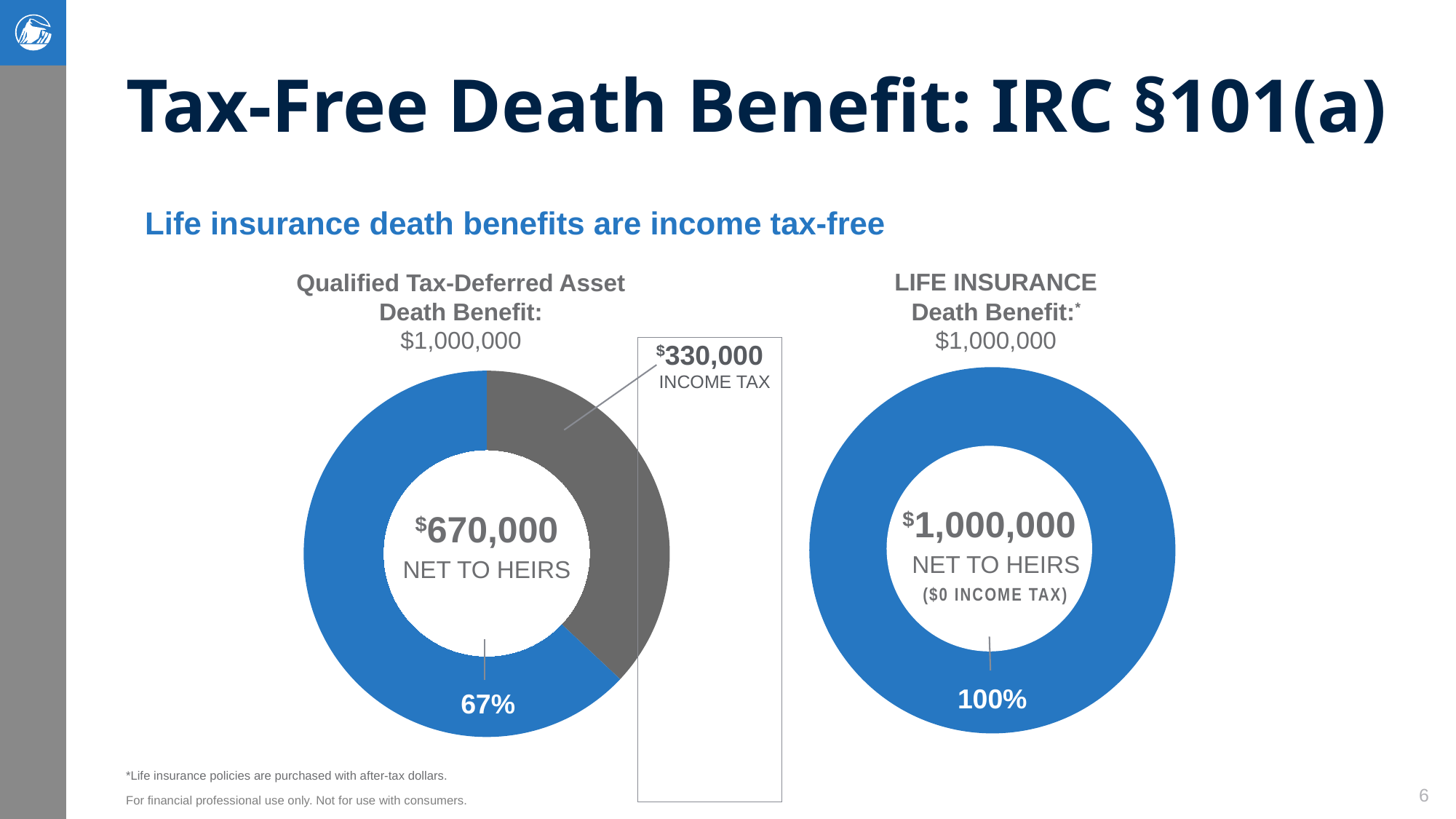
What kind of chart is used on the left side of the slide for the Qualified Tax-Deferred Asset Death Benefit? Pie (donut) chart In the Qualified Tax-Deferred Asset Death Benefit chart, what amount is shown as net to heirs? $670,000 In the Life Insurance Death Benefit chart, what amount is shown as net to heirs? $1,000,000 What is the total death benefit shown for the Qualified Tax-Deferred Asset chart? $1,000,000 In the Qualified Tax-Deferred Asset Death Benefit chart, what is the difference between the net to heirs and the income tax? $340,000 In the Qualified Tax-Deferred Asset Death Benefit chart, what colour is the income tax slice? Gray In the Life Insurance Death Benefit chart, how much income tax is shown? $0 In the Qualified Tax-Deferred Asset Death Benefit chart, which is larger: the net to heirs or the income tax? Net to heirs In the Qualified Tax-Deferred Asset Death Benefit chart, what percentage of the death benefit goes to heirs? 67% How many slices does the Qualified Tax-Deferred Asset Death Benefit chart have? 2 In the Qualified Tax-Deferred Asset Death Benefit chart, what amount is shown as income tax? $330,000 In the Life Insurance Death Benefit chart, what percentage of the death benefit goes to heirs? 100%